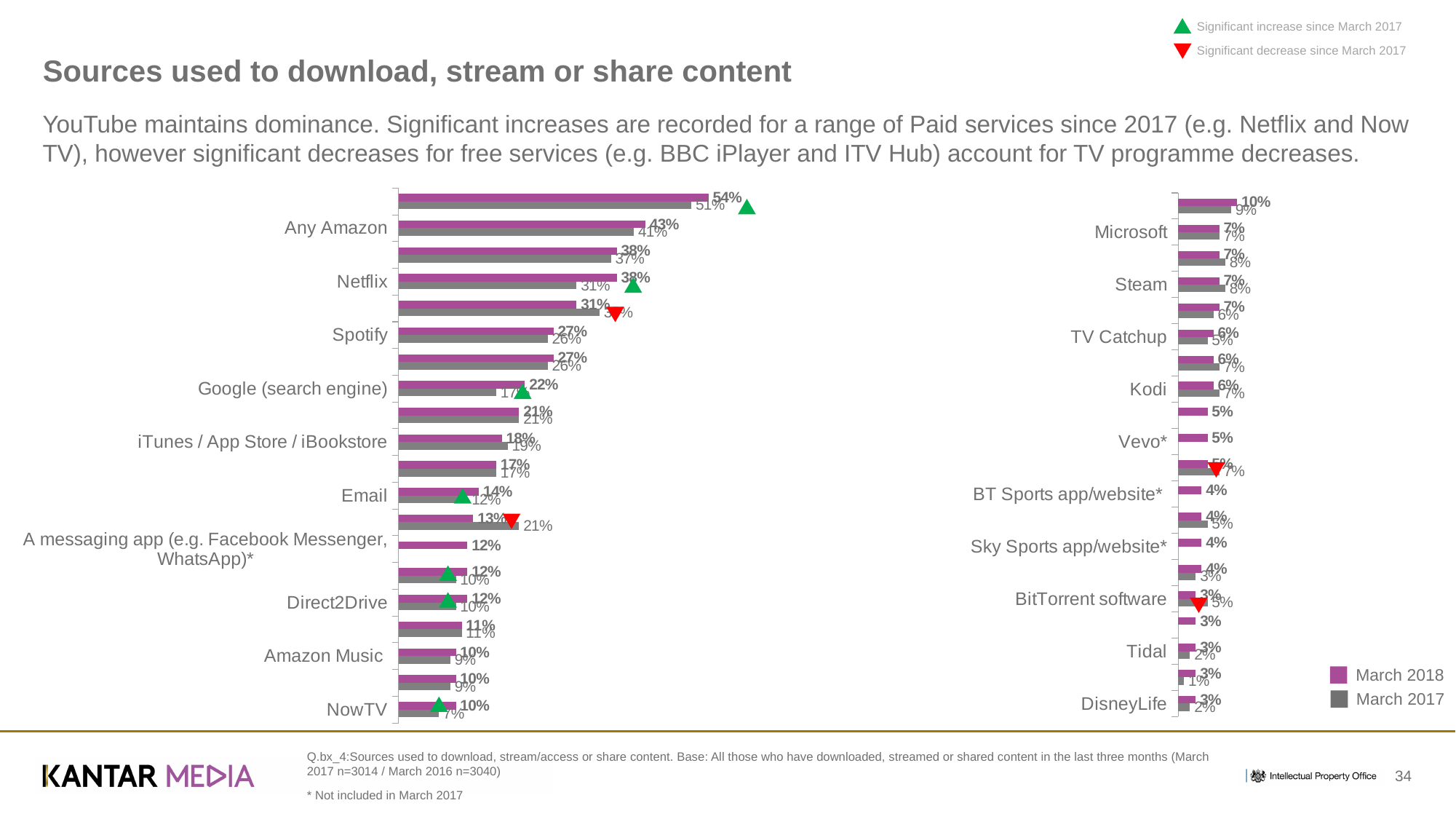
In the left chart, what is the March 2017 value for Netflix? 31% In the left chart, by how many percentage points did NowTV change from March 2017 to March 2018? 3 percentage points In the left chart, which has the higher March 2018 value, Google (search engine) or iTunes / App Store / iBookstore? Google (search engine) How many series does the legend list? 2 In the right chart, what is the March 2018 value for Tidal? 3% In the right chart, what is the March 2017 value for Kodi? 7% What type of chart is used on this slide? Bar chart In the left chart, what is the March 2018 value for Email? 14% In the left chart, what is the March 2018 value for Any Amazon? 43% In the left chart, what is the March 2017 value for NowTV? 7% In the left chart, what is the March 2018 value for Netflix? 38% In the right chart, what is the March 2017 value for BitTorrent software? 5%